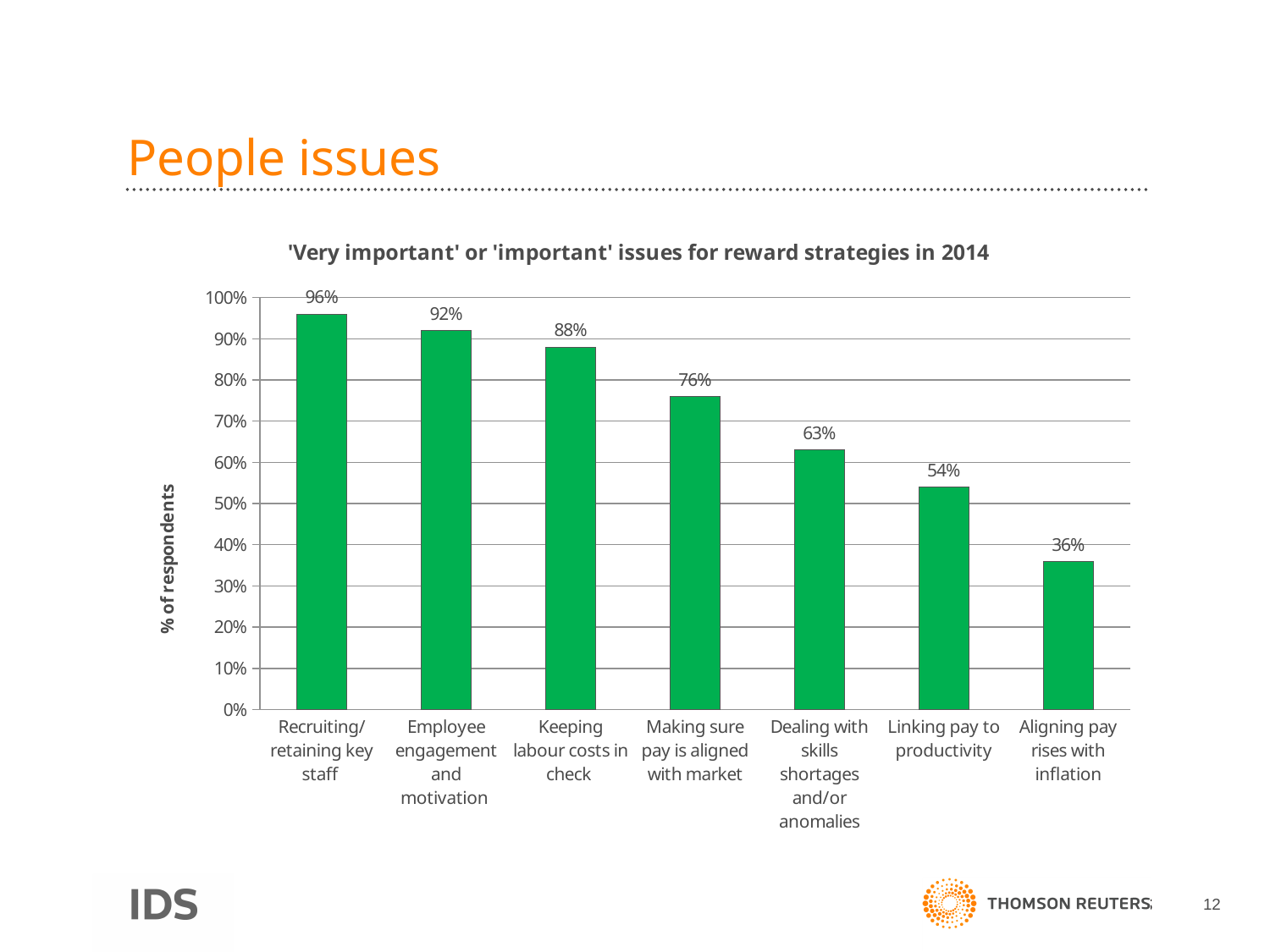
Do the values rise or fall moving from left to right along the x axis? Fall What is the value for 'Dealing with skills shortages and/or anomalies'? 63% How many issues (categories) are shown on the chart? 7 What is the label on the vertical axis of the chart? % of respondents What percentage of respondents rated 'Recruiting/retaining key staff' as a very important or important issue? 96% Which issue has the lowest percentage of respondents? Aligning pay rises with inflation Which issue has the highest percentage of respondents? Recruiting/retaining key staff What kind of chart is shown on the slide? Bar chart Is the value for 'Aligning pay rises with inflation' greater or less than 40%? less What is the value for 'Linking pay to productivity'? 54% What is the difference between the values for 'Employee engagement and motivation' and 'Making sure pay is aligned with market'? 16% Which is larger: the value for 'Keeping labour costs in check' or the value for 'Linking pay to productivity'? Keeping labour costs in check